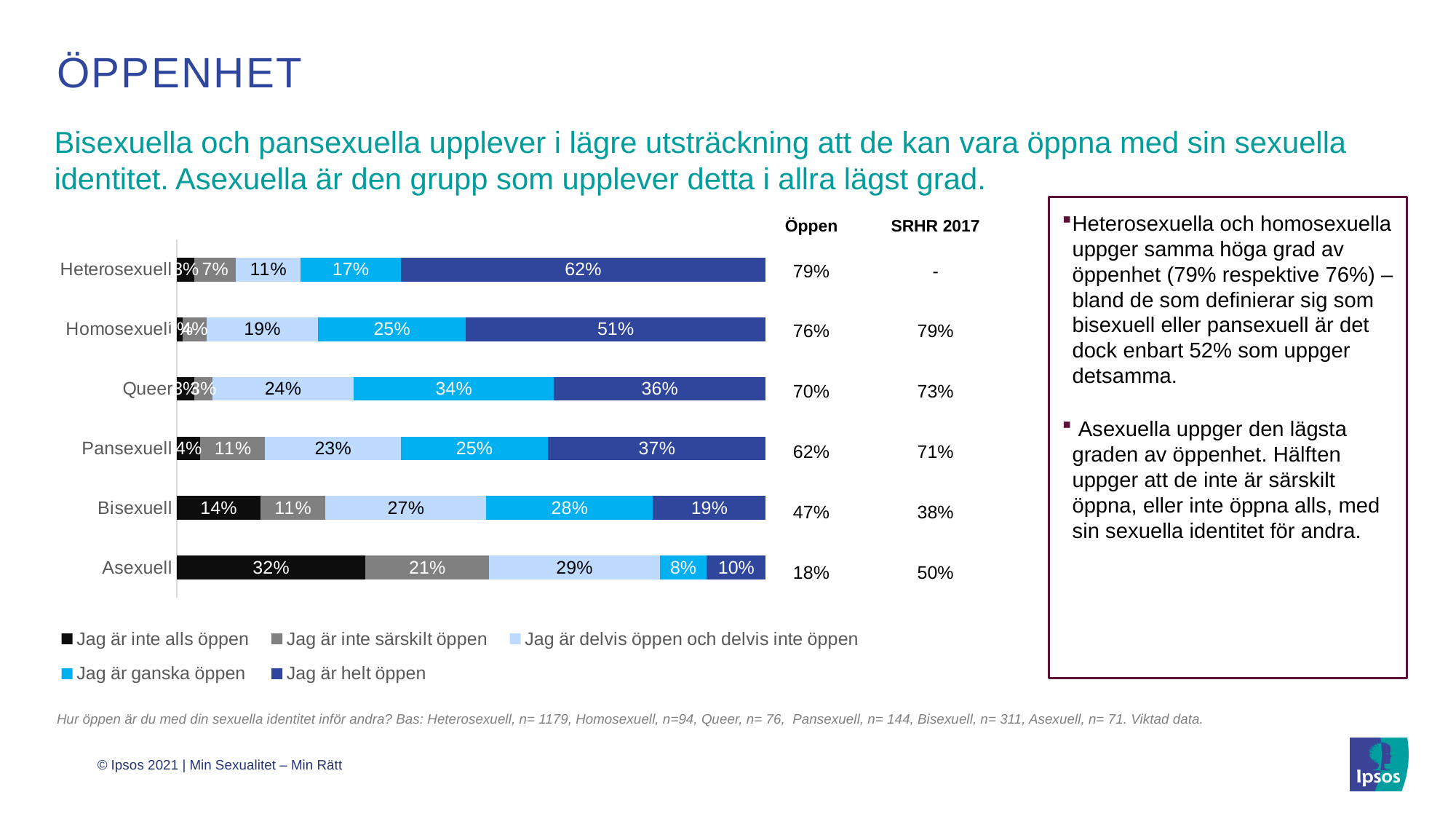
What is the value for 'Jag är ganska öppen' in the Queer bar? 34% Which group has the lowest value for 'Jag är helt öppen'? Asexuell What is the value for 'Jag är ganska öppen' in the Bisexuell bar? 28% How many categories (groups) are shown on the y axis of the chart? 6 What is the value for 'Jag är inte alls öppen' in the Asexuell bar? 32% What kind of chart is shown on the slide? Stacked bar chart How many series does the chart legend list? 5 Which legend entry is shown in black in the chart? Jag är inte alls öppen What is the value for 'Jag är helt öppen' in the Heterosexuell bar? 62% Which has the larger value for 'Jag är delvis öppen och delvis inte öppen': Pansexuell or Bisexuell? Bisexuell What is the difference between the 'Jag är helt öppen' values for Homosexuell and Queer? 15 percentage points Which group has the highest value for 'Jag är helt öppen'? Heterosexuell